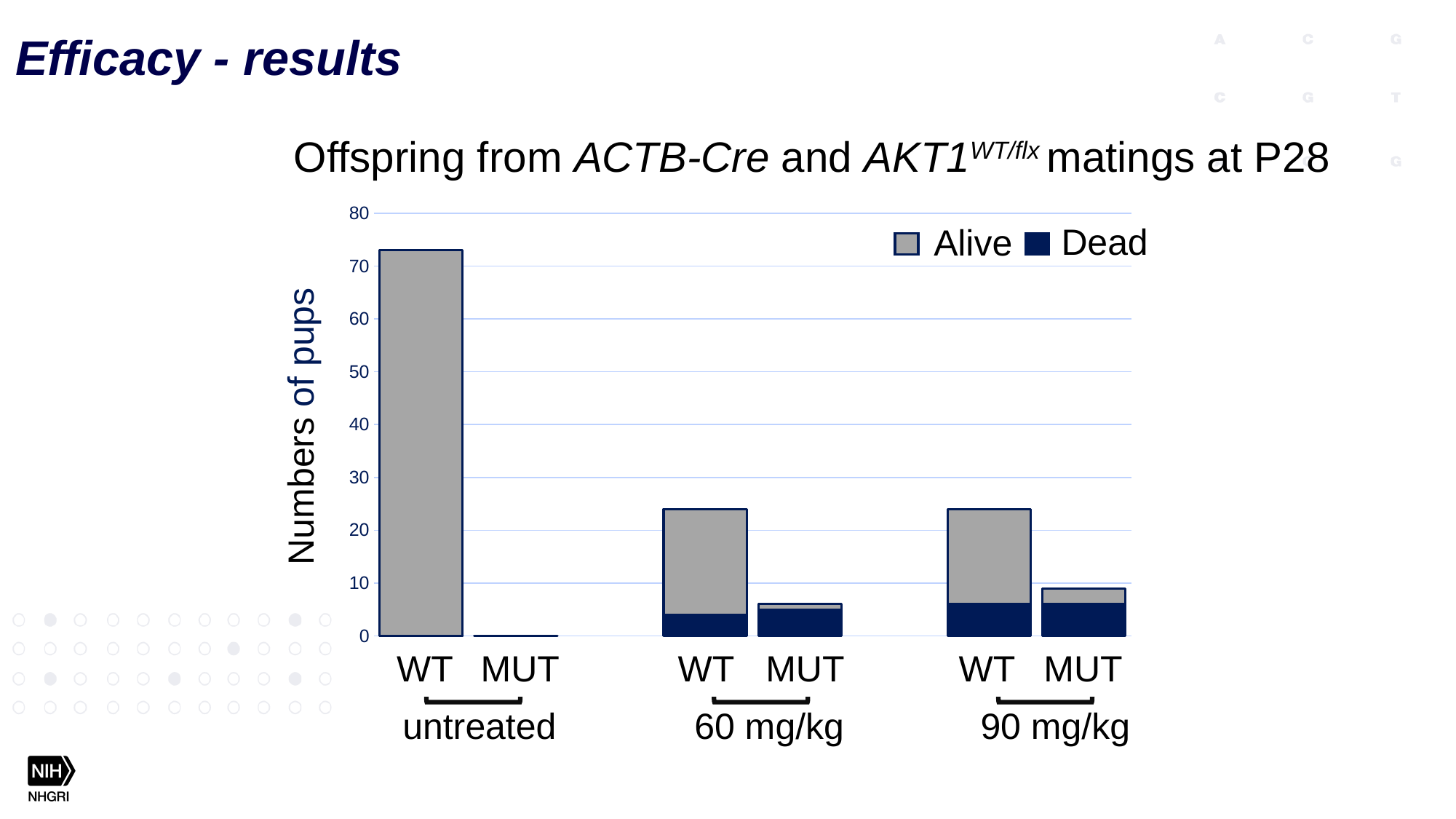
Is the total number of pups for untreated WT greater or less than 70? greater Which bar has the highest total number of pups? untreated WT Is the total number of pups for MUT at 90 mg/kg greater or less than 20? less What kind of chart is shown on the slide? Stacked bar chart Which has more total pups: WT at 60 mg/kg or MUT at 60 mg/kg? WT at 60 mg/kg What is the label on the vertical axis of the chart? Numbers of pups How many bars (genotype/treatment groups) are plotted in the chart? 6 How many series does the chart legend list? 2 Is the total number of pups for WT at 60 mg/kg greater or less than 20? greater Which series is shown in dark navy in the chart legend? Dead Which bar has the lowest total number of pups? untreated MUT